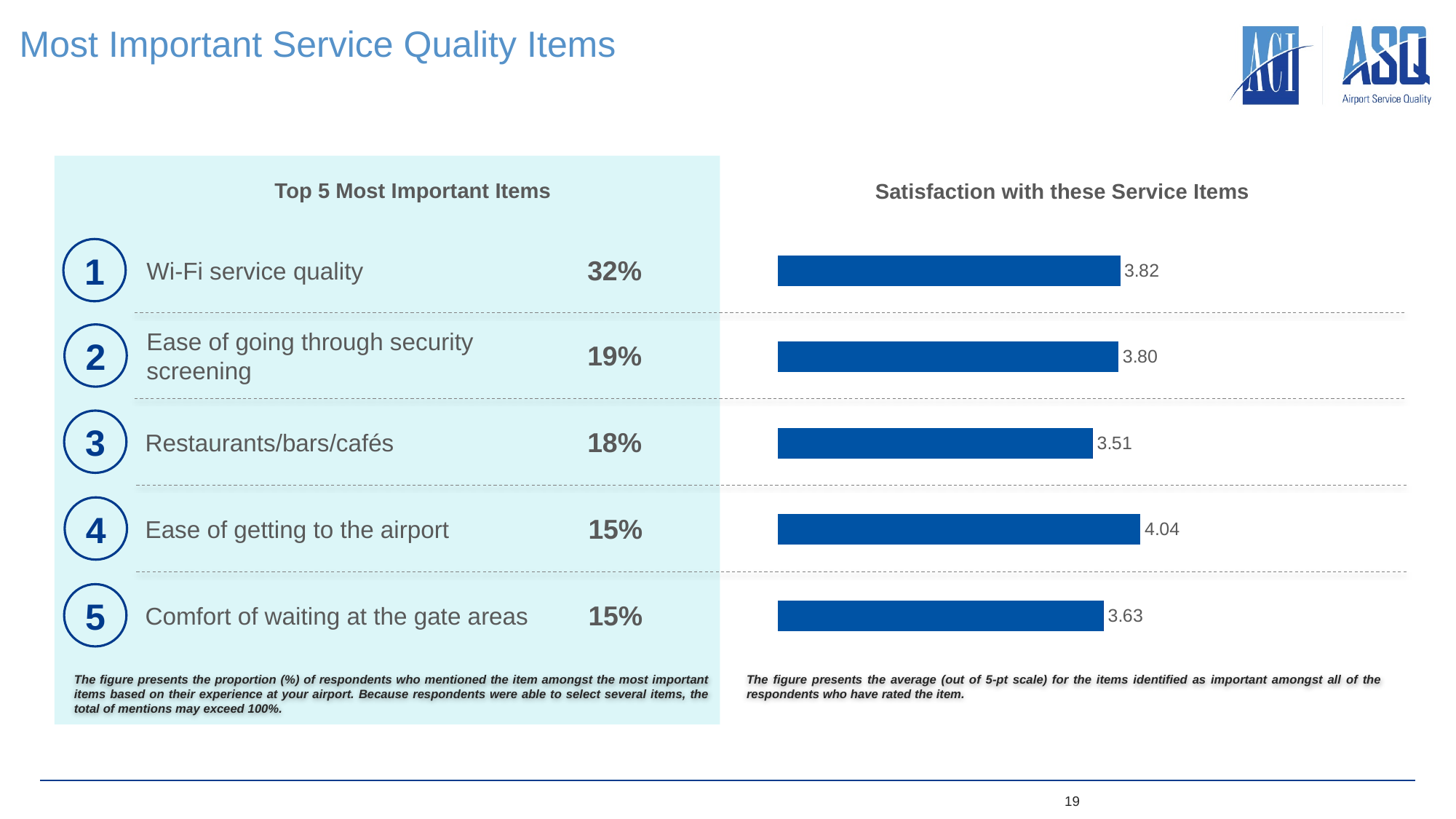
What percentage of respondents mentioned Ease of going through security screening as a most important item? 19% Which item has the highest satisfaction score? Ease of getting to the airport How many items are shown in the satisfaction bar chart? 5 What is the satisfaction score for Restaurants/bars/cafés? 3.51 Which item has the lowest satisfaction score? Restaurants/bars/cafés What is the title of the chart on the right side of the slide? Satisfaction with these Service Items What is the difference between the satisfaction scores for Ease of getting to the airport and Restaurants/bars/cafés? 0.53 What is the satisfaction score for Wi-Fi service quality? 3.82 What is the satisfaction score for Comfort of waiting at the gate areas? 3.63 Which has a higher satisfaction score, Wi-Fi service quality or Comfort of waiting at the gate areas? Wi-Fi service quality What kind of chart is used to show satisfaction with the service items? Bar chart What is the satisfaction score for Ease of getting to the airport? 4.04